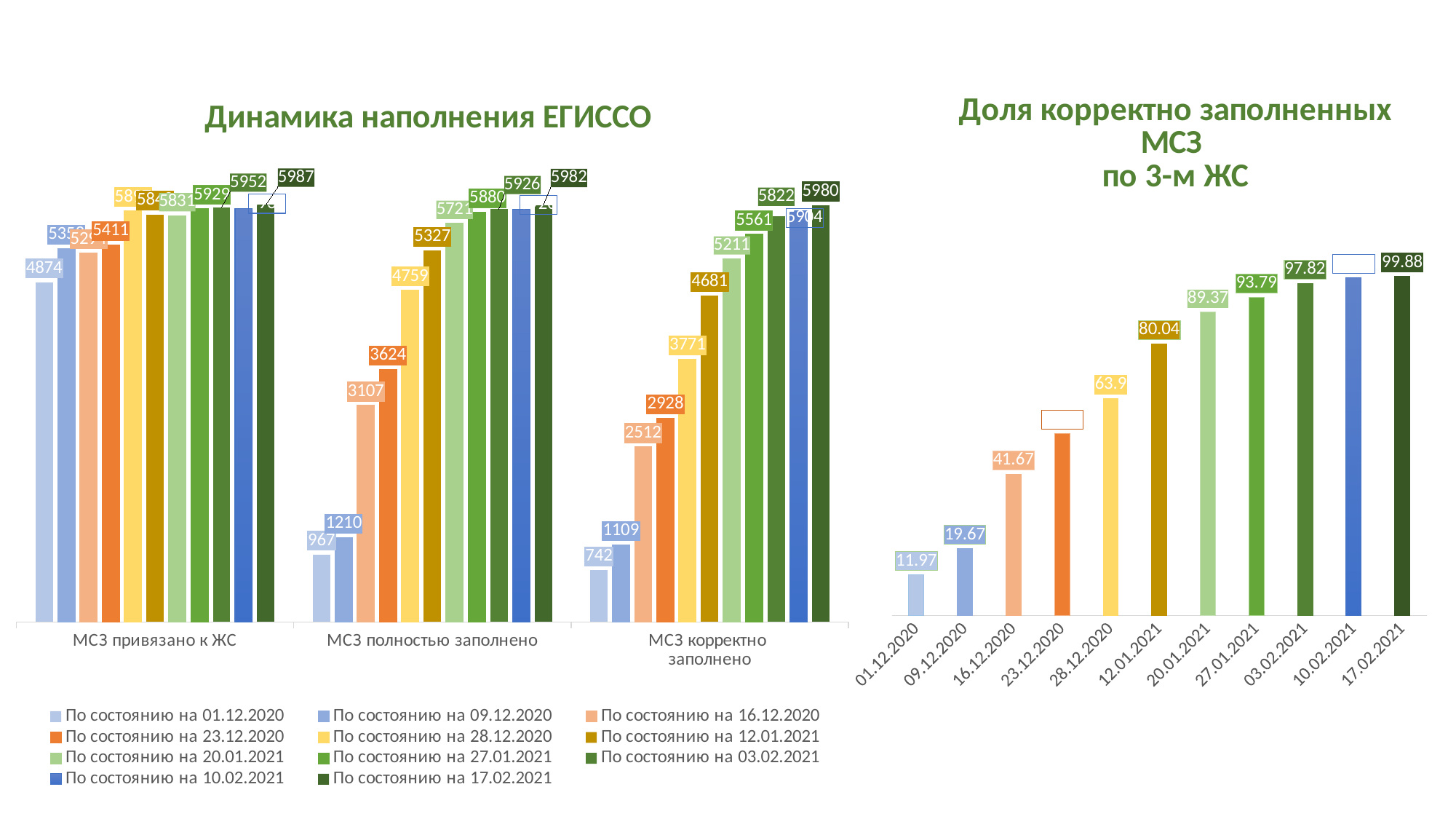
In the chart "Доля корректно заполненных МСЗ по 3-м ЖС", how many dates are shown on the x axis? 11 In the chart "Динамика наполнения ЕГИССО", what is the difference between the "МСЗ корректно заполнено" values as of 17.02.2021 and 01.12.2020? 5238 In the chart "Доля корректно заполненных МСЗ по 3-м ЖС", do the values rise or fall from left to right along the x axis? rise In the chart "Доля корректно заполненных МСЗ по 3-м ЖС", what is the value for 12.01.2021? 80.04 In the chart "Доля корректно заполненных МСЗ по 3-м ЖС", which date has the lowest value? 01.12.2020 In the chart "Доля корректно заполненных МСЗ по 3-м ЖС", what is the value for 17.02.2021? 99.88 In the chart "Динамика наполнения ЕГИССО", as of 16.12.2020, which is larger: "МСЗ полностью заполнено" or "МСЗ корректно заполнено"? МСЗ полностью заполнено What kind of chart is the chart titled "Доля корректно заполненных МСЗ по 3-м ЖС"? bar chart In the chart "Динамика наполнения ЕГИССО", what is the value for "МСЗ корректно заполнено" as of 01.12.2020? 742 In the chart "Динамика наполнения ЕГИССО", how many series does the legend list? 11 In the chart "Динамика наполнения ЕГИССО", how many categories are shown on the x axis? 3 In the chart "Динамика наполнения ЕГИССО", what is the value for "МСЗ полностью заполнено" as of 23.12.2020? 3624